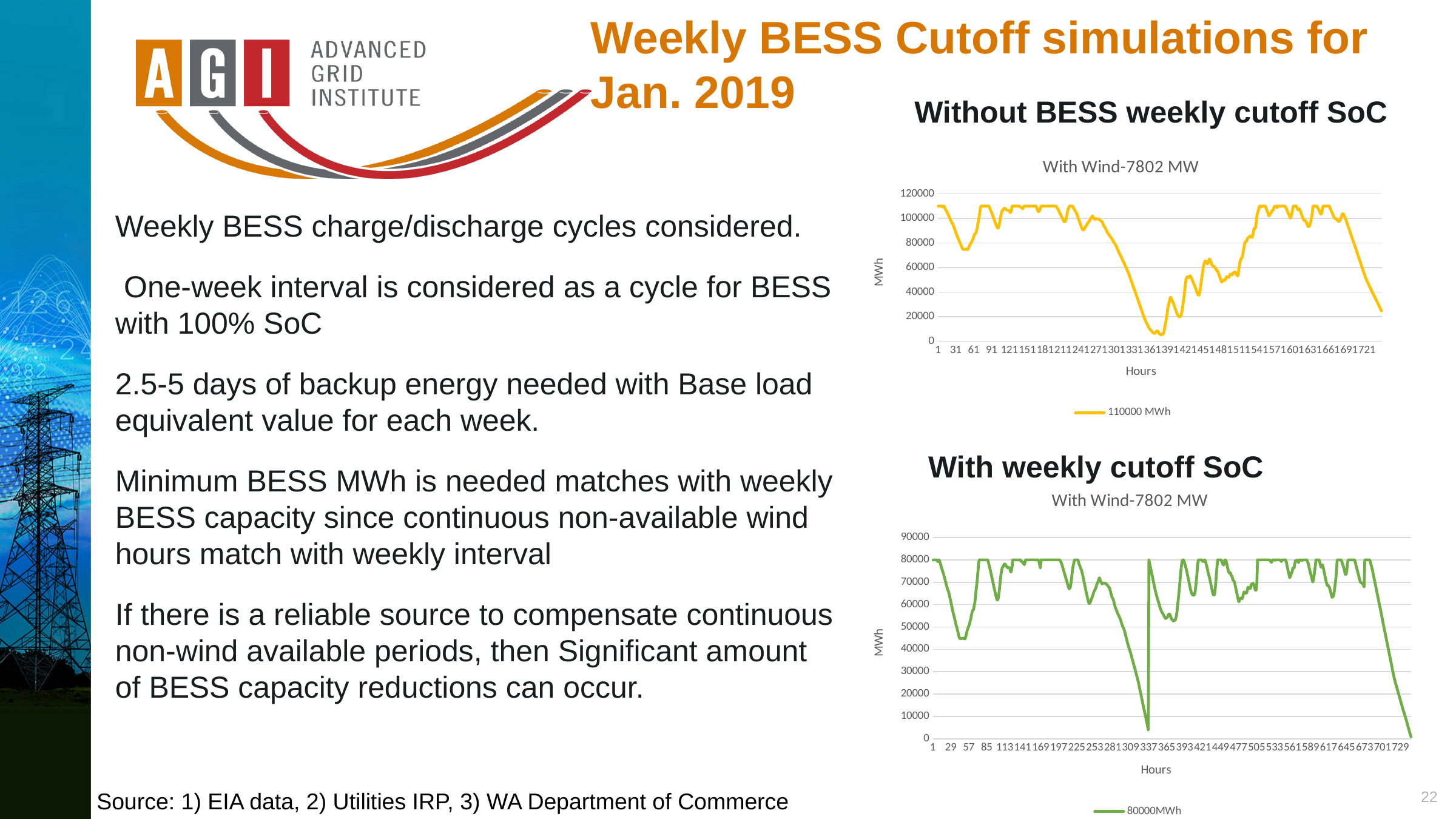
In the top chart ('Without BESS weekly cutoff SoC'), is the value at hour 1 greater or less than 100000? greater In the bottom chart ('With weekly cutoff SoC'), what is the legend entry for the plotted series? 80000MWh What kind of chart is the bottom chart, titled 'With weekly cutoff SoC'? line chart In the bottom chart ('With weekly cutoff SoC'), is the value at hour 1 greater or less than 70000? greater In the bottom chart ('With weekly cutoff SoC'), do the values rise or fall over the final hours of the x axis? fall In the bottom chart ('With weekly cutoff SoC'), is the highest plotted value greater or less than 90000? less In the top chart ('Without BESS weekly cutoff SoC'), what is the legend entry for the plotted series? 110000 MWh What kind of chart is the top chart, titled 'Without BESS weekly cutoff SoC'? line chart In the top chart ('Without BESS weekly cutoff SoC'), how many series does the legend list? 1